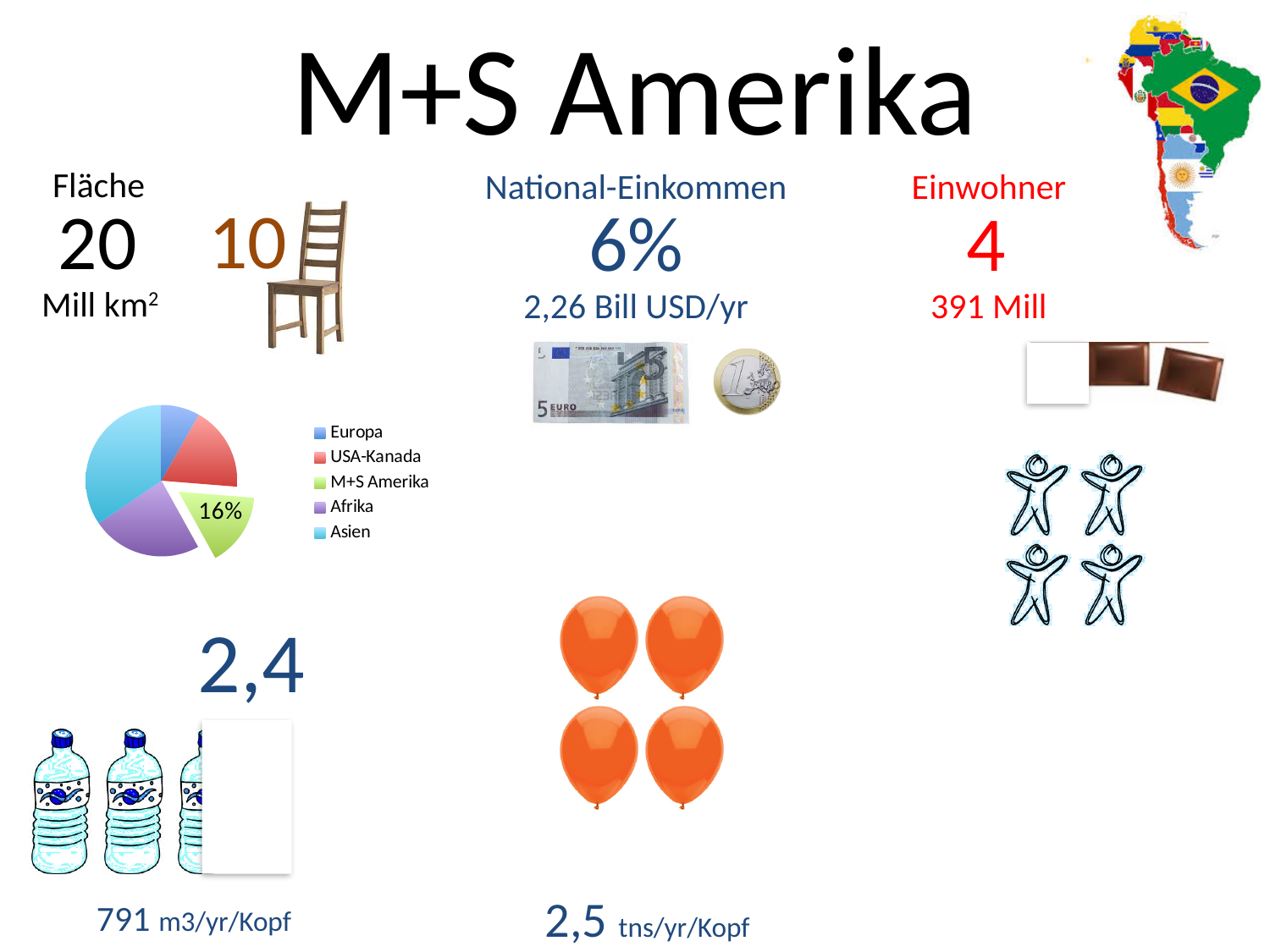
What value is printed on the M+S Amerika slice of the pie chart? 16% Which slice is pulled out from the rest of the pie chart? M+S Amerika Which slice is larger in the pie chart, Europa or M+S Amerika? M+S Amerika Which slice is larger in the pie chart, Asien or Europa? Asien What share of the pie does the M+S Amerika slice have? 16% What kind of chart is shown on the slide? pie chart How many categories does the pie chart's legend list? 5 Which category has the smallest slice in the pie chart? Europa Which category has the largest slice in the pie chart? Asien What colour is the M+S Amerika slice in the pie chart? green Which slice is larger in the pie chart, Asien or M+S Amerika? Asien